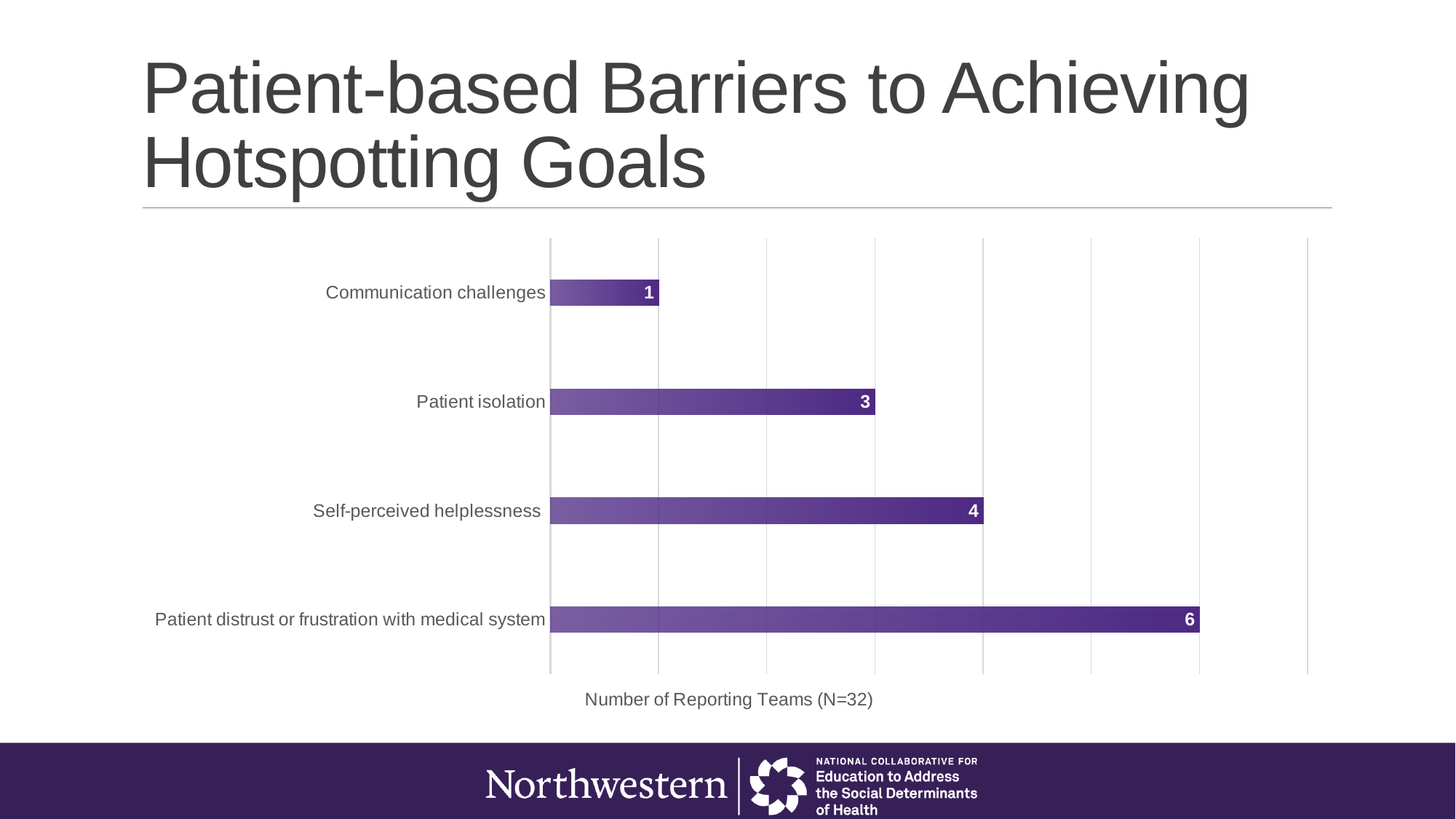
What is the value for Communication challenges? 1 How many reporting teams cited Patient isolation as a barrier? 3 Which barrier was reported by the most teams? Patient distrust or frustration with medical system What is the difference between the number of teams reporting Patient distrust or frustration with medical system and those reporting Patient isolation? 3 How many barrier categories are shown in the chart? 4 Which was reported by more teams: Self-perceived helplessness or Patient isolation? Self-perceived helplessness Which barrier was reported by the fewest teams? Communication challenges How many reporting teams cited Patient distrust or frustration with medical system? 6 What is the total number of reports across all four barriers? 14 What kind of chart is shown on the slide? Bar chart What is the label of the horizontal axis? Number of Reporting Teams (N=32) What is the value for Self-perceived helplessness? 4